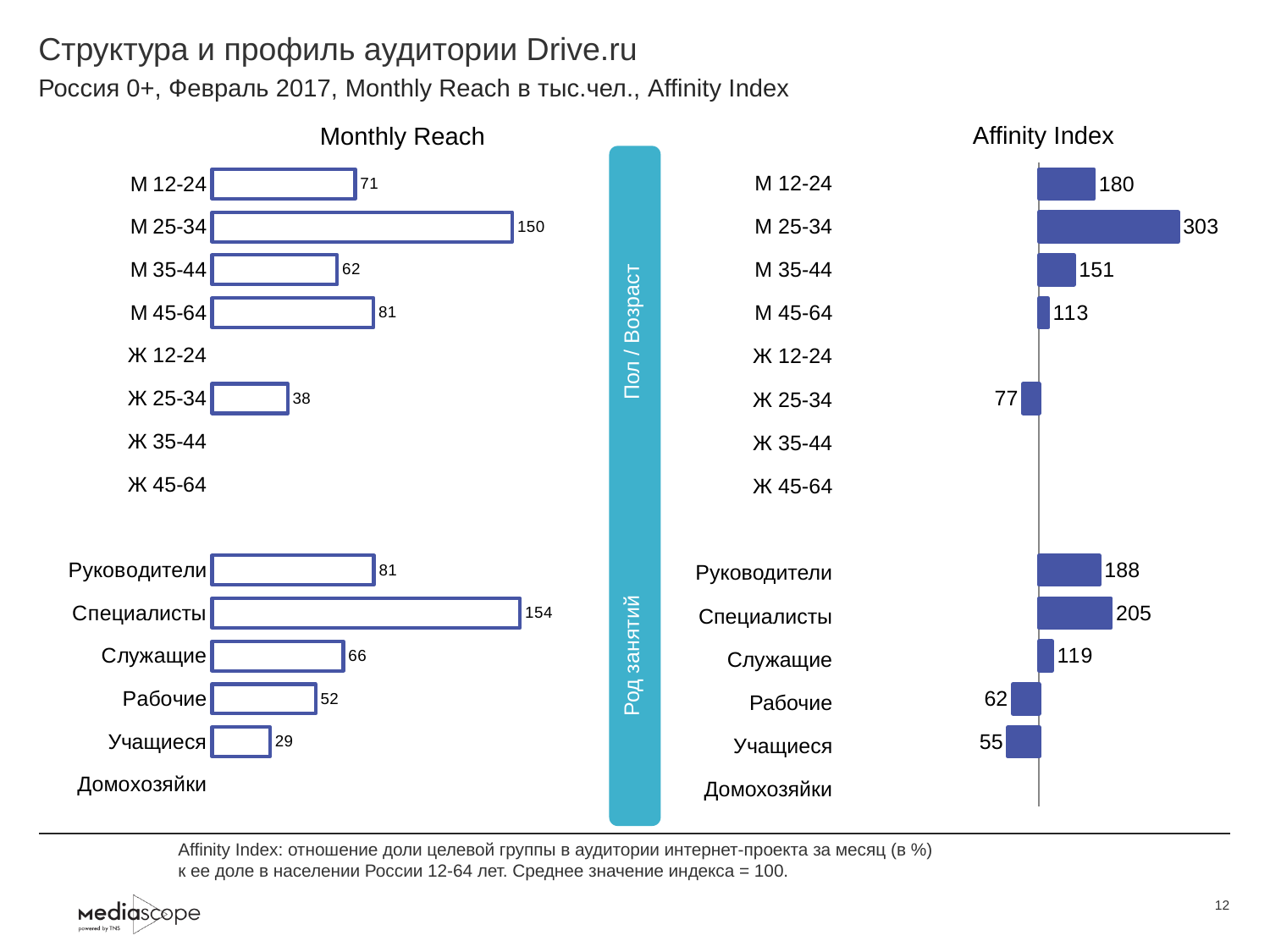
What type of chart is the Affinity Index chart? Bar chart In the Monthly Reach chart, which is larger: the value for М 45-64 or the value for М 35-44? М 45-64 In the Affinity Index chart, which category has the highest value? М 25-34 In the Affinity Index chart, what is the difference between the values for М 25-34 and М 12-24? 123 In the Monthly Reach chart, which occupation category (Род занятий) has the highest value? Специалисты In the Monthly Reach chart, what is the difference between the values for Специалисты and Руководители? 73 In the Affinity Index chart, which is larger: the value for Рабочие or the value for Учащиеся? Рабочие In the Affinity Index chart, what is the value for Служащие? 119 In the Affinity Index chart, what is the value for Ж 25-34? 77 In the Monthly Reach chart, which occupation category (Род занятий) with a plotted bar has the lowest value? Учащиеся In the Affinity Index chart, what is the value for Специалисты? 205 In the Monthly Reach chart, what is the value for М 25-34? 150